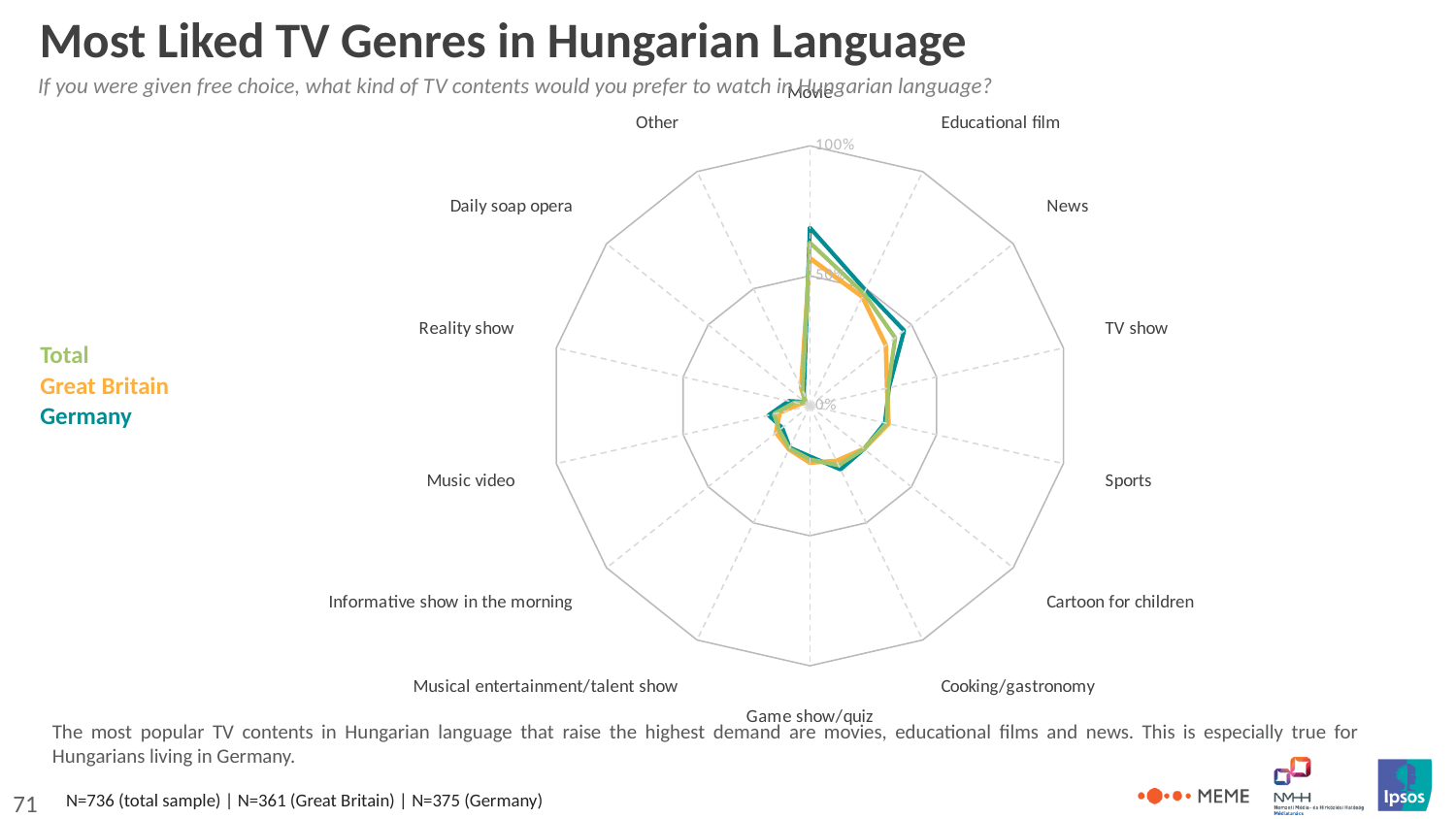
Which has a larger value for Germany, Movie or Sports? Movie Is the value for Daily soap opera for Total greater or less than 50%? less Is the value for Movie for Germany greater or less than 50%? greater What is the title of the chart on the slide? Most Liked TV Genres in Hungarian Language How many series does the legend list? 3 Which has a larger value for Total, Movie or Music video? Movie How many TV genre categories are plotted on the radar chart? 14 Is the value for Sports for Germany greater or less than 50%? less Which TV genre has the highest value on the chart? Movie Which series is shown in orange in the legend? Great Britain What kind of chart is shown on the slide? Radar chart